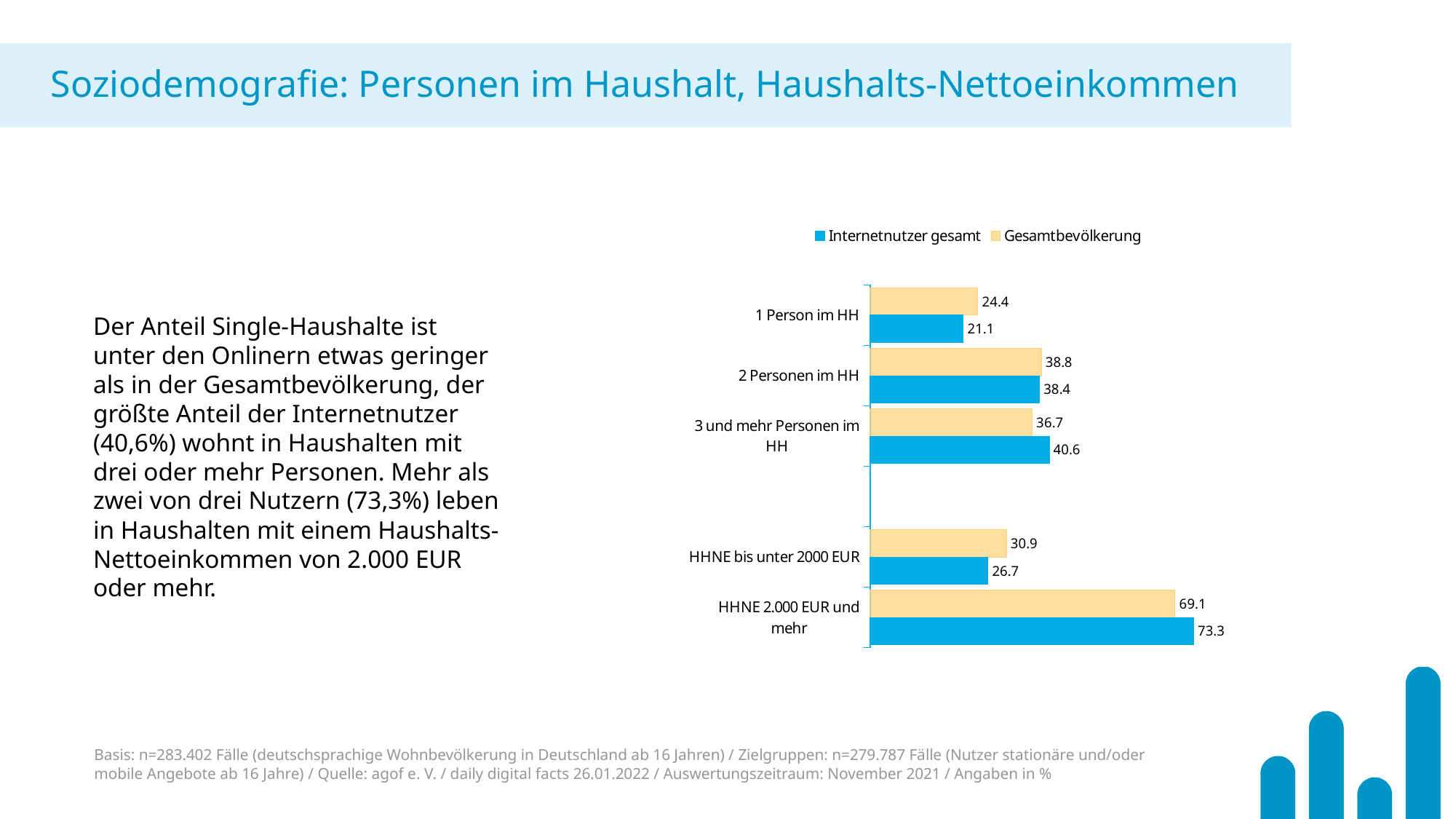
How many series does the legend list? 2 Which category has the highest value for Internetnutzer gesamt? HHNE 2.000 EUR und mehr Which category has the lowest value for Gesamtbevölkerung? 1 Person im HH What is the value for Gesamtbevölkerung in the category 3 und mehr Personen im HH? 36.7 In the category 3 und mehr Personen im HH, which series has the larger value, Internetnutzer gesamt or Gesamtbevölkerung? Internetnutzer gesamt In the category HHNE bis unter 2000 EUR, which series has the larger value, Internetnutzer gesamt or Gesamtbevölkerung? Gesamtbevölkerung What is the value for Internetnutzer gesamt in the category 1 Person im HH? 21.1 How many categories are shown on the chart? 5 What is the difference between Gesamtbevölkerung and Internetnutzer gesamt in the category 1 Person im HH? 3.3 What kind of chart is shown on the slide? Bar chart What is the value for Gesamtbevölkerung in the category HHNE bis unter 2000 EUR? 30.9 What is the difference between Internetnutzer gesamt and Gesamtbevölkerung in the category HHNE 2.000 EUR und mehr? 4.2